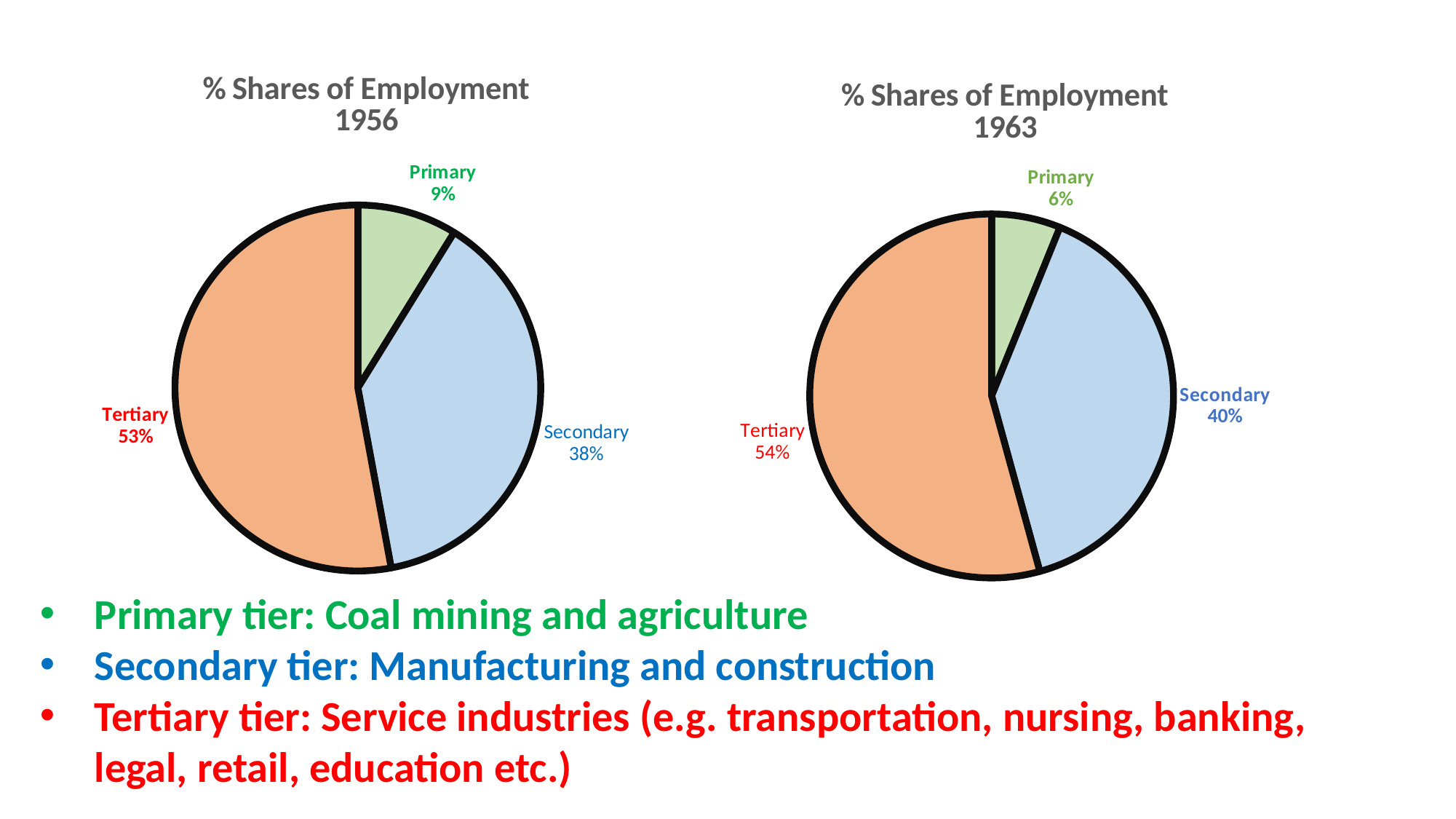
What type of chart is the '% Shares of Employment 1956' chart? Pie chart How many categories does the '% Shares of Employment 1963' chart show? 3 In the '% Shares of Employment 1963' chart, what is the difference between the Secondary and Primary shares? 34% In the '% Shares of Employment 1956' chart, what colour is the Tertiary slice? Orange Is the Secondary share larger in the 1956 chart or the 1963 chart? 1963 In the '% Shares of Employment 1956' chart, what is the difference between the Tertiary and Secondary shares? 15% In the '% Shares of Employment 1956' chart, which category has the largest share? Tertiary In the '% Shares of Employment 1963' chart, which category has the smallest share? Primary In the '% Shares of Employment 1963' chart, what is the share for Primary? 6% In the '% Shares of Employment 1956' chart, what is the share for Tertiary? 53% In the '% Shares of Employment 1956' chart, what is the share for Primary? 9% In the '% Shares of Employment 1963' chart, what is the share for Secondary? 40%